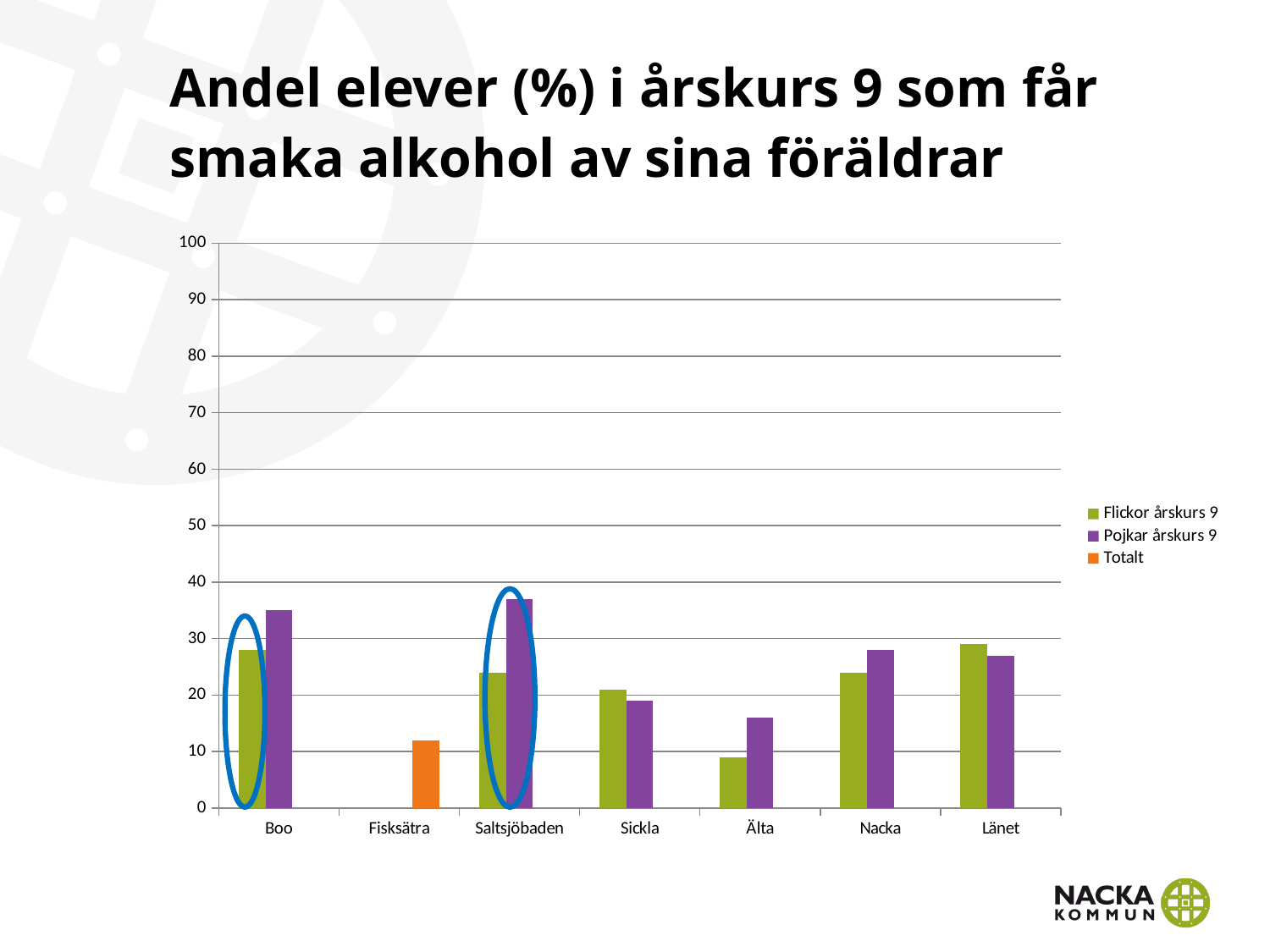
Which category is the only one with a Totalt (orange) bar? Fisksätra Is the value for Pojkar årskurs 9 in Boo greater or less than 30? greater In Älta, which is larger: Flickor årskurs 9 or Pojkar årskurs 9? Pojkar årskurs 9 Is the value for Totalt in Fisksätra greater or less than 10? greater How many categories are shown on the x axis? 7 How many series does the legend list? 3 Which category has the lowest value for Flickor årskurs 9? Älta Is the value for Pojkar årskurs 9 in Nacka greater or less than 30? less In Boo, which is larger: Flickor årskurs 9 or Pojkar årskurs 9? Pojkar årskurs 9 Which category has the lowest value for Pojkar årskurs 9? Älta What kind of chart is shown on the slide? bar chart